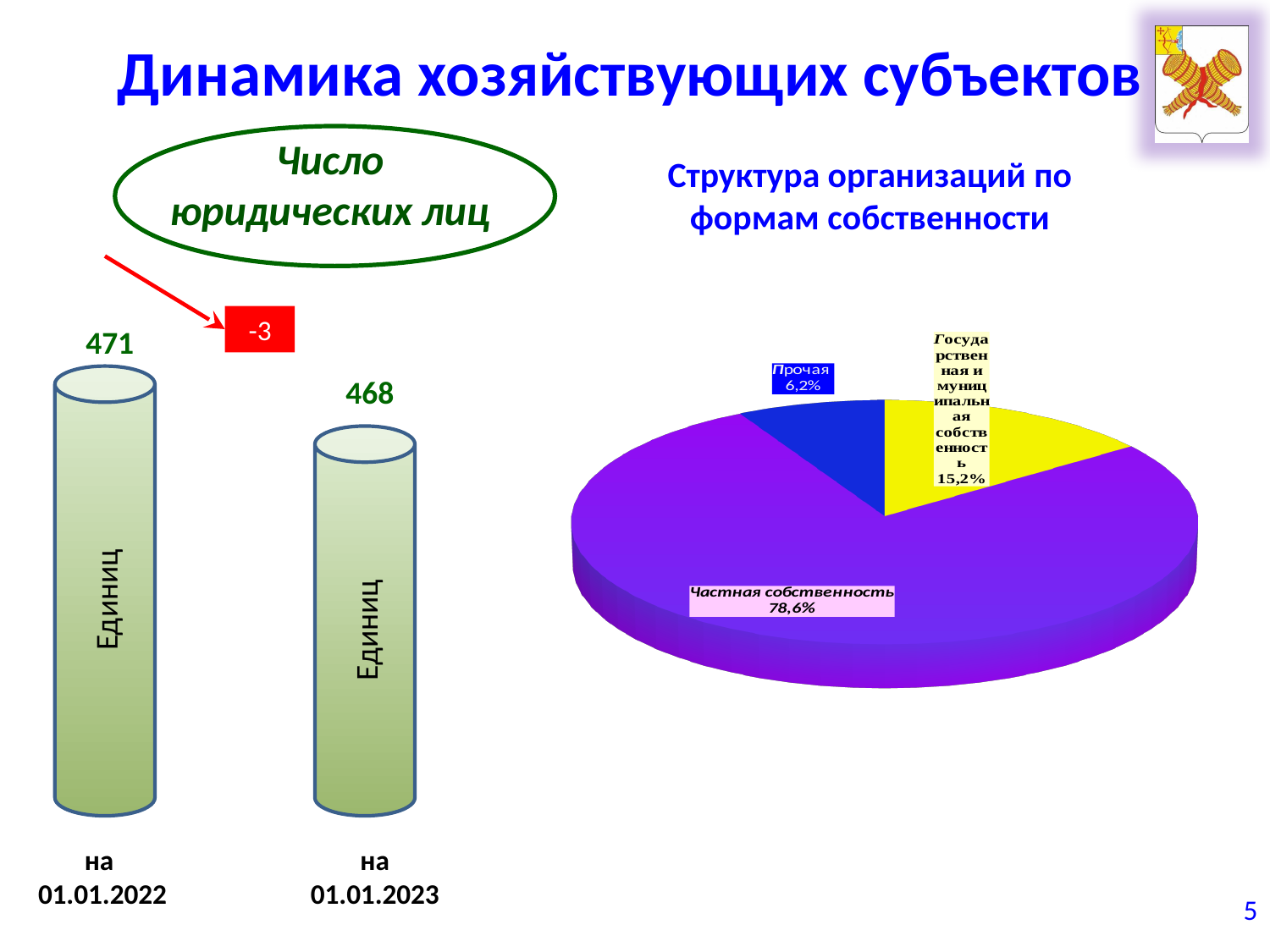
In the pie chart 'Структура организаций по формам собственности', what is the share of 'Частная собственность'? 78,6% In the chart 'Число юридических лиц' on the left, what is the value for 01.01.2022? 471 In the pie chart 'Структура организаций по формам собственности', which slice is the smallest? Прочая In the chart 'Число юридических лиц' on the left, do the values rise or fall from 01.01.2022 to 01.01.2023? fall In the chart 'Число юридических лиц' on the left, what is the value for 01.01.2023? 468 How many slices does the pie chart 'Структура организаций по формам собственности' have? 3 In the chart 'Число юридических лиц' on the left, which date has the higher value, 01.01.2022 or 01.01.2023? 01.01.2022 What kind of chart is 'Число юридических лиц' on the left of the slide? bar chart How many bars are shown in the chart 'Число юридических лиц' on the left? 2 In the pie chart 'Структура организаций по формам собственности', what is the share of 'Государственная и муниципальная собственность'? 15,2% In the pie chart 'Структура организаций по формам собственности', what is the share of 'Прочая'? 6,2% In the chart 'Число юридических лиц' on the left, what is the difference between the value for 01.01.2022 and the value for 01.01.2023? 3